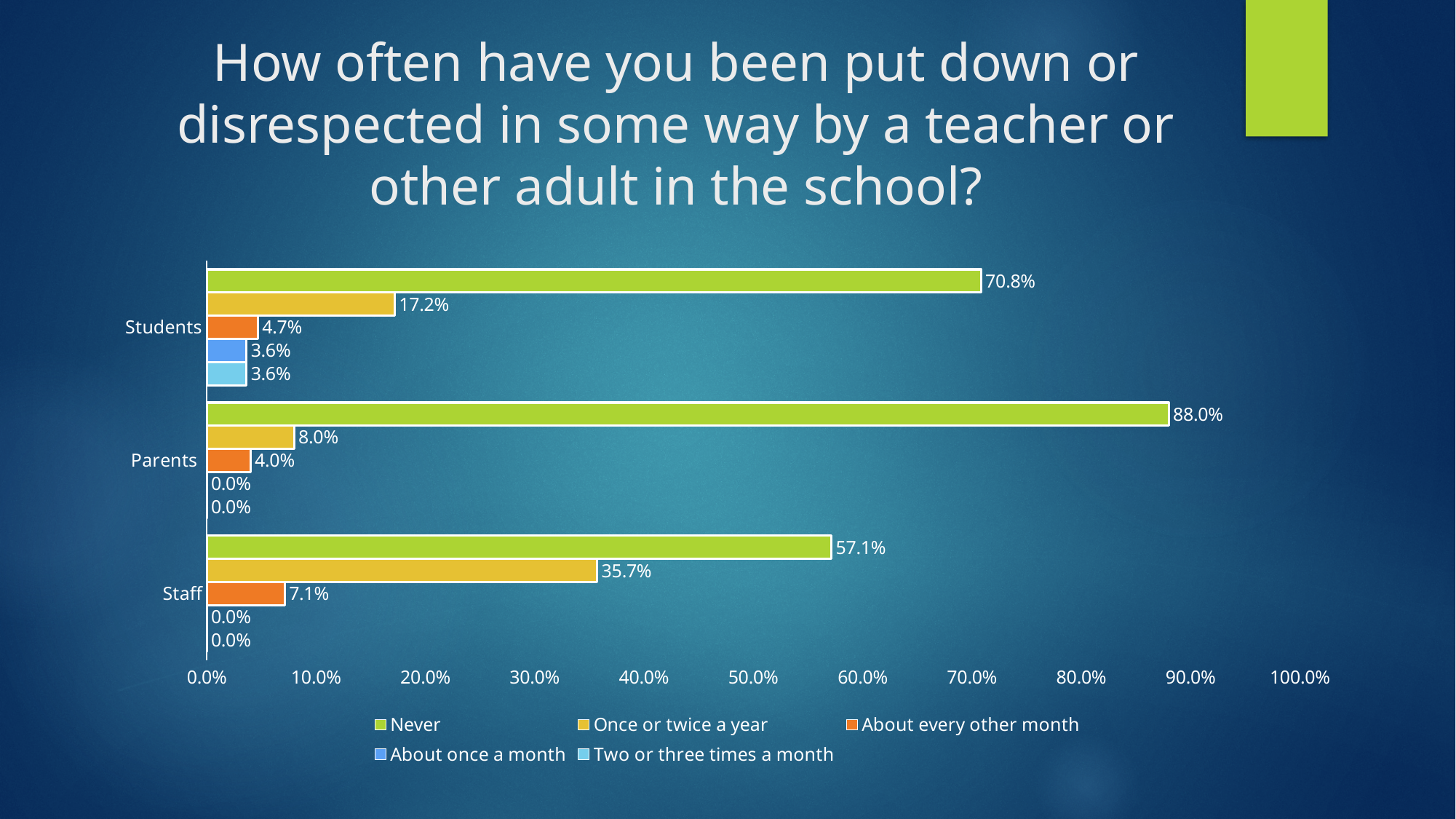
Which group has the lowest "Never" percentage? Staff How many groups (categories) are shown on the chart? 3 Which is larger: the "Once or twice a year" value for Students or for Staff? Staff What is the total of the "About once a month" and "Two or three times a month" values for Students? 7.2% What is the difference between the "Never" percentages for Parents and Staff? 30.9% What percentage of Staff answered "Once or twice a year"? 35.7% What percentage of Students answered "Never"? 70.8% How many series does the legend list? 5 Which group has the highest "Never" percentage? Parents What percentage of Parents answered "About every other month"? 4.0% What kind of chart is shown on the slide? Bar chart What is the title of the chart? How often have you been put down or disrespected in some way by a teacher or other adult in the school?